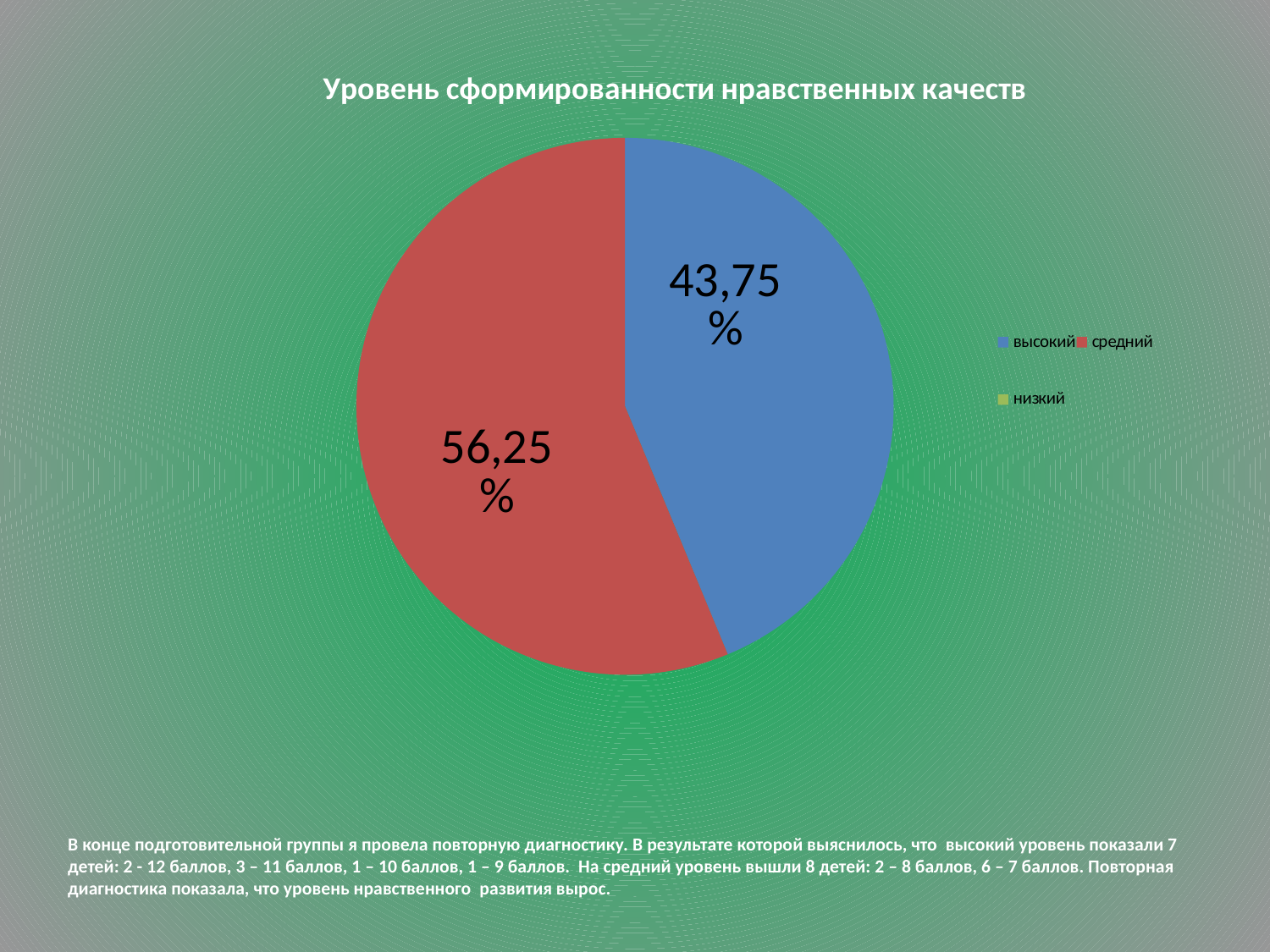
What type of chart is shown on the slide? pie chart What percentage is shown for the 'средний' slice? 56,25% What is the title of the chart? Уровень сформированности нравственных качеств What colour is the 'средний' slice? red What is the difference between the 'средний' and 'высокий' percentages? 12,5% What percentage is shown for the 'высокий' slice? 43,75% How many entries does the legend list? 3 What share of the pie does the 'высокий' slice represent? 43,75% Is the 'средний' slice larger or smaller than the 'высокий' slice? larger Which of the two labelled slices is smaller, 'высокий' or 'средний'? высокий Which category has the largest slice of the pie? средний Is the value for 'высокий' greater or less than 50%? less